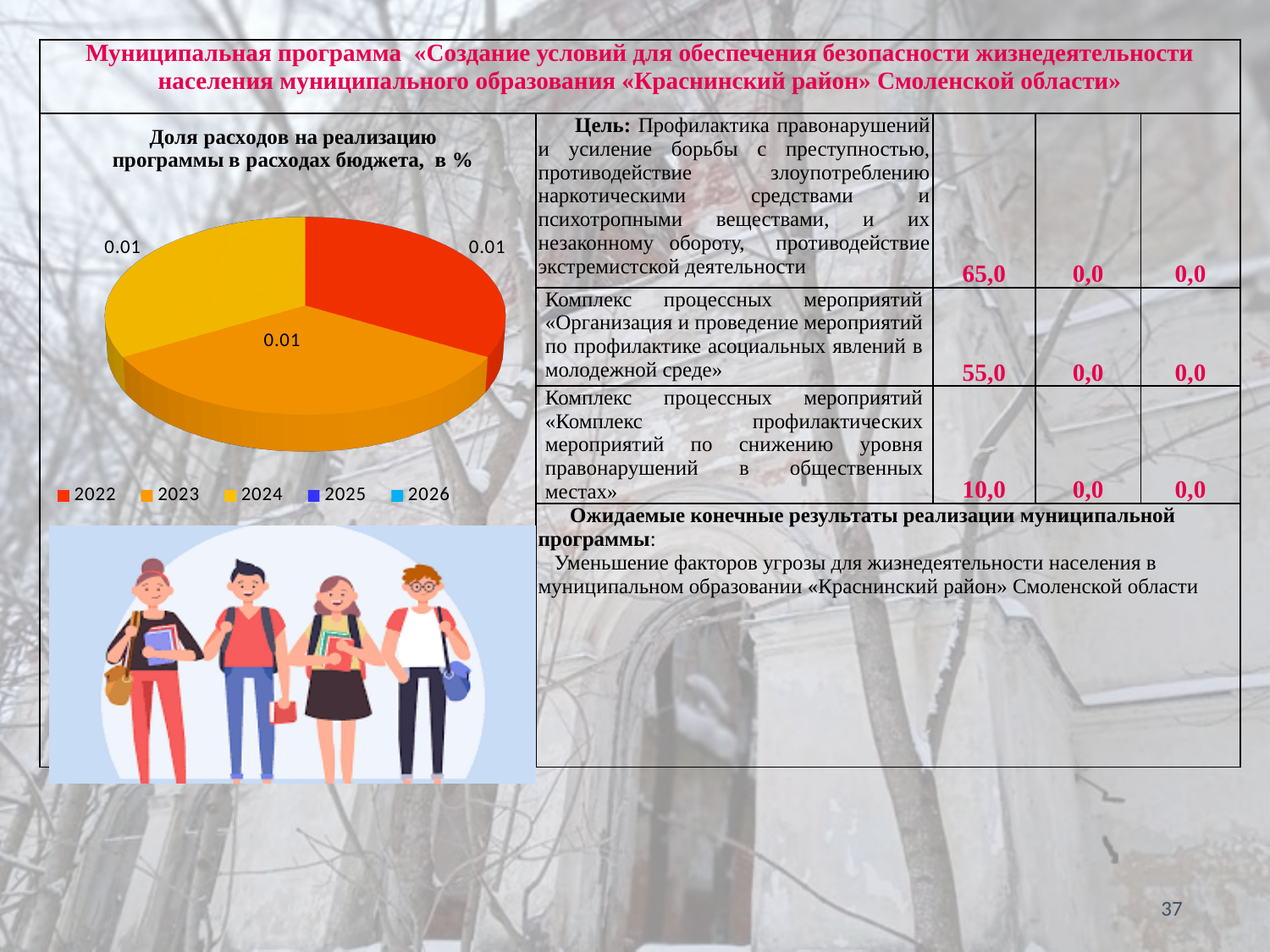
What value is labelled on the 2024 slice of the pie chart? 0.01 What kind of chart is shown on the slide? Pie chart What is the difference between the labelled values for 2022 and 2023 in the pie chart? 0 Which years are listed in the legend of the pie chart? 2022, 2023, 2024, 2025, 2026 How many slices with data labels are visible in the pie chart? 3 What is the title of the pie chart? Доля расходов на реализацию программы в расходах бюджета, в % What value is labelled on the 2022 slice of the pie chart? 0.01 What value is labelled on the 2023 slice of the pie chart? 0.01 How many entries does the legend of the pie chart list? 5